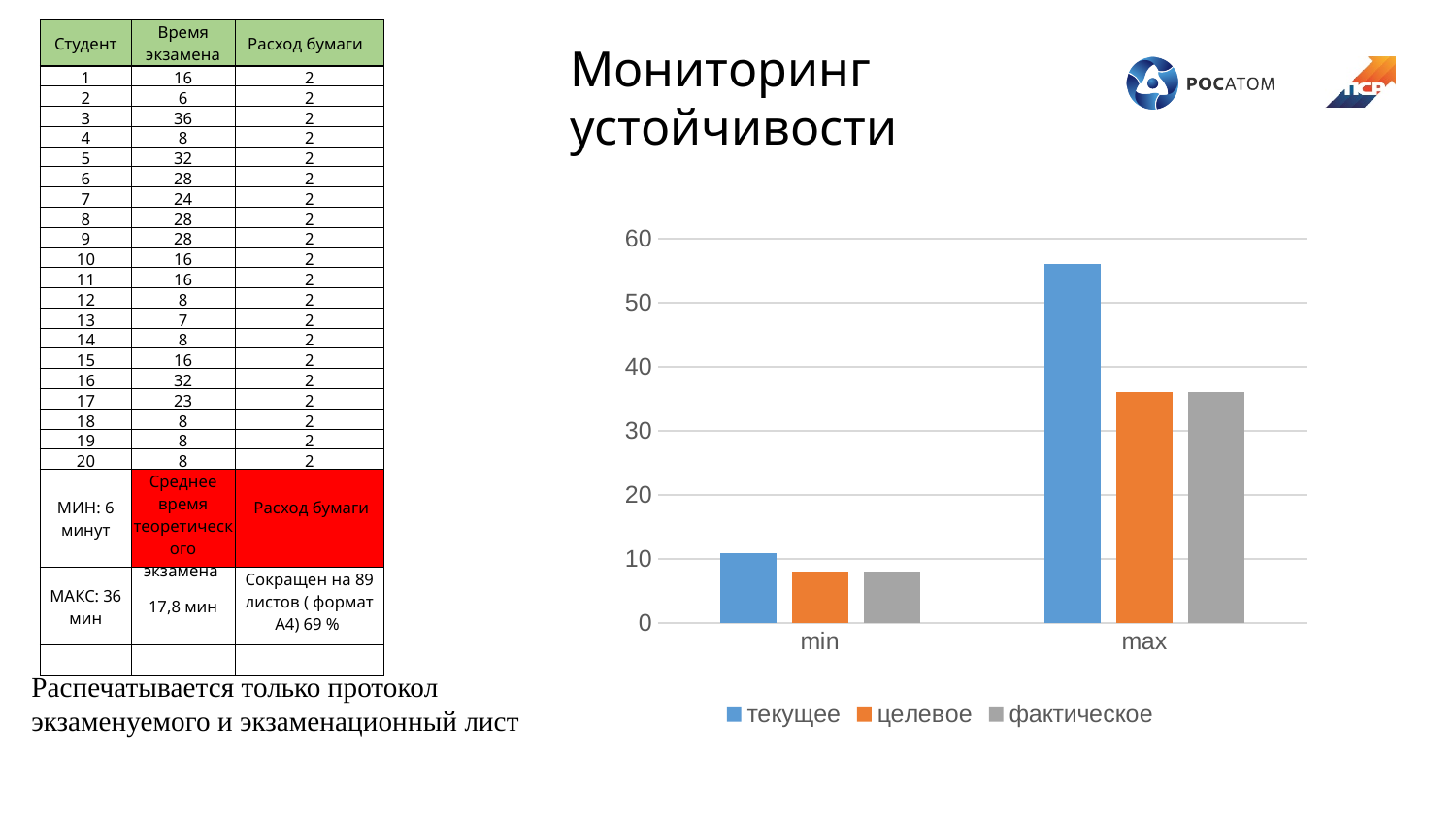
For the max category, which is larger: текущее or целевое? текущее What are the two categories on the x axis of the chart? min and max How many series does the chart legend list? 3 Which series has the highest value in the max category? текущее How many categories are shown on the x axis of the chart? 2 For the min category, which is larger: текущее or фактическое? текущее Is the value of фактическое for max greater or less than 30? greater Which series is shown in blue in the chart? текущее Is the value of целевое for max greater or less than 40? less What kind of chart is shown on the slide? bar chart Is the value of целевое for min greater or less than 10? less